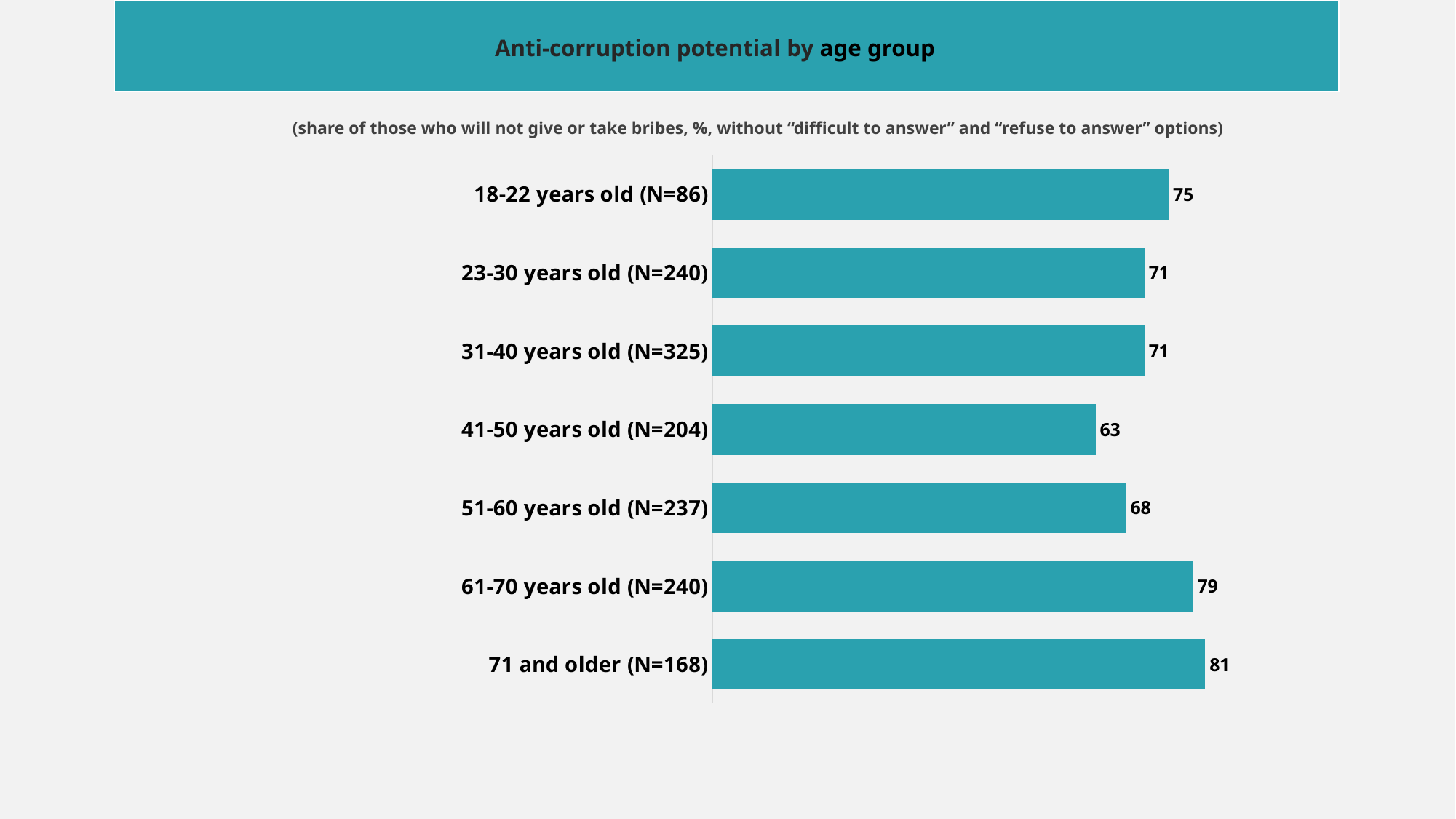
What is the value for the 18-22 years old (N=86) age group? 75 What is the title of the chart? Anti-corruption potential by age group What is the difference between the values for 18-22 years old (N=86) and 23-30 years old (N=240)? 4 Which has a larger value, 61-70 years old (N=240) or 51-60 years old (N=237)? 61-70 years old (N=240) What is the value for the 41-50 years old (N=204) age group? 63 What kind of chart is shown on the slide? Bar chart Which age group has the lowest value? 41-50 years old (N=204) How many age groups are shown in the chart? 7 What is the value for the 61-70 years old (N=240) age group? 79 What is the difference between the values for 71 and older (N=168) and 41-50 years old (N=204)? 18 Which age group has the highest value? 71 and older (N=168) What is the value for the 51-60 years old (N=237) age group? 68